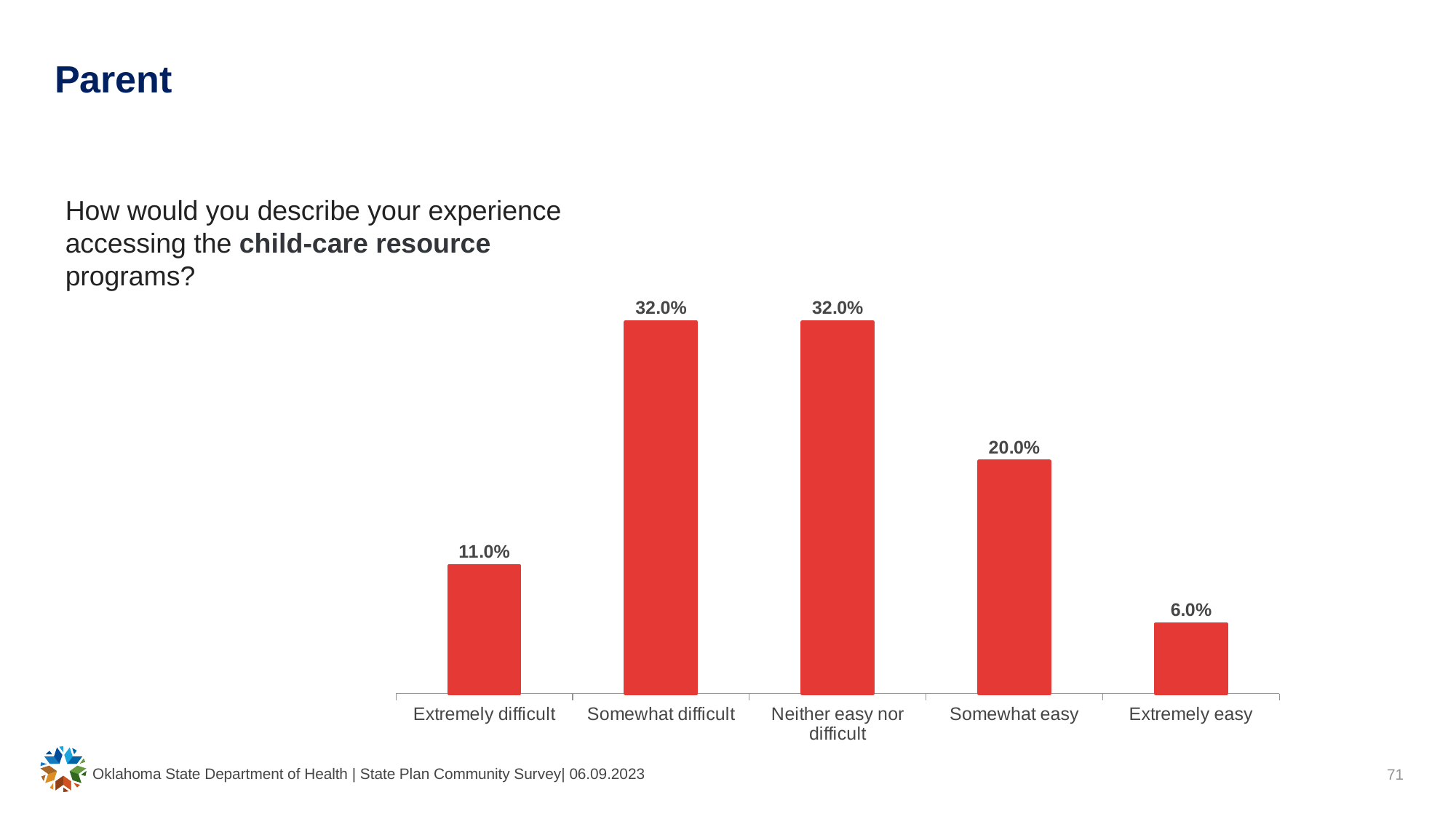
Which two categories share the highest value on the chart? Somewhat difficult and Neither easy nor difficult What is the value shown for Extremely easy? 6.0% How many response categories are shown on the chart? 5 What percentage of parents described their experience accessing child-care resource programs as Extremely difficult? 11.0% Which category has the lowest value? Extremely easy What kind of chart is shown on the slide? Bar chart What is the value shown for Somewhat easy? 20.0% What is the difference between the values for Extremely difficult and Extremely easy? 5.0% What is the difference between the values for Somewhat difficult and Somewhat easy? 12.0% What colour are the bars in the chart? Red What is the value shown for Neither easy nor difficult? 32.0% Which is larger, the value for Extremely difficult or the value for Somewhat easy? Somewhat easy